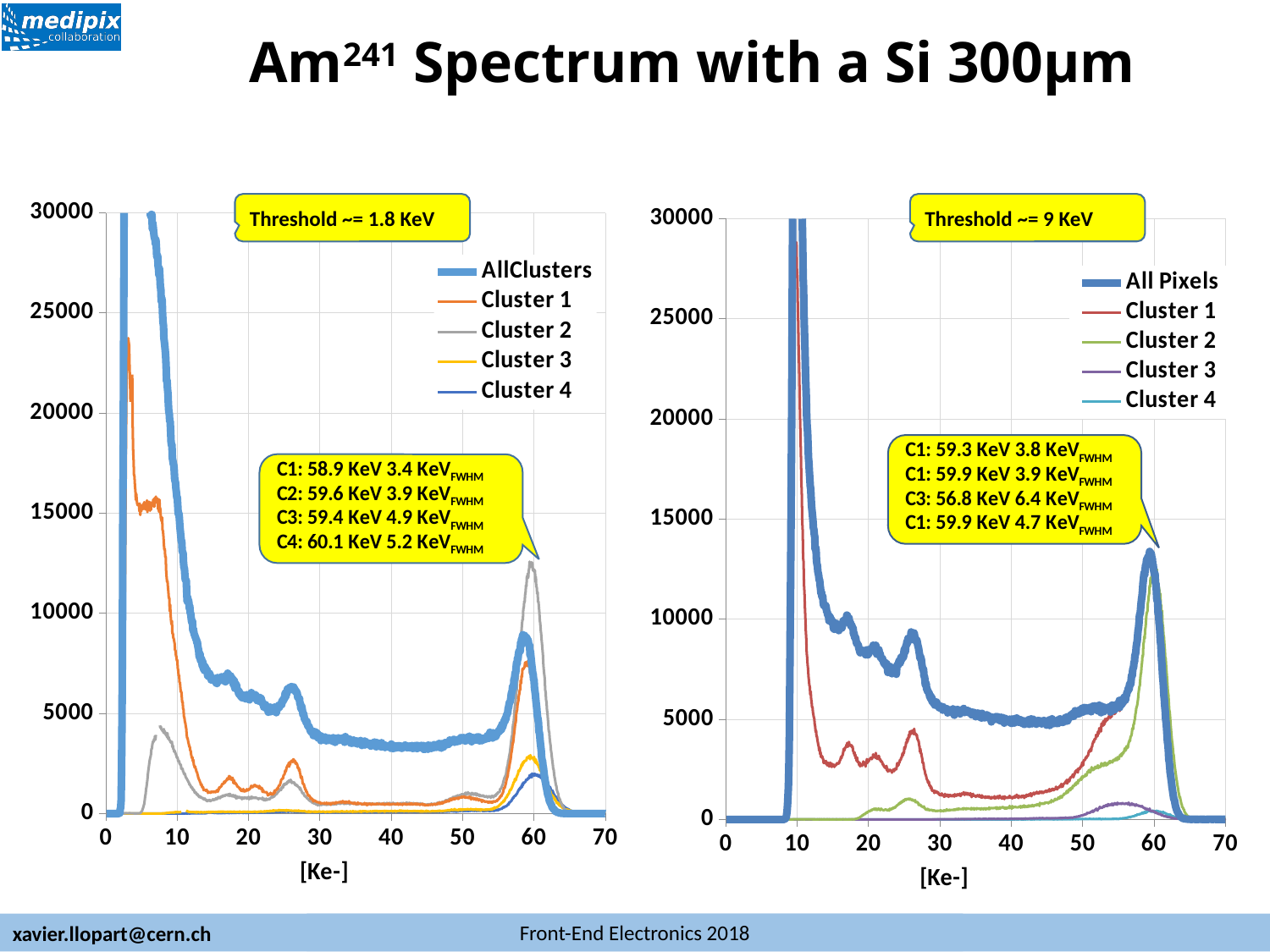
In the left chart, is the peak of Cluster 1 near 3 Ke- greater or less than 20000? greater In the right chart, which series is higher at 60 Ke-, Cluster 2 or Cluster 3? Cluster 2 What kind of chart is shown on the left of the slide? line chart How many series does the legend of the left chart list? 5 In the right chart, which series has the highest value at 30 Ke-? All Pixels In the left chart, is the peak of Cluster 2 near 60 Ke- greater or less than 10000? greater In the right chart, is the peak of All Pixels near 60 Ke- greater or less than 10000? greater What threshold is stated in the yellow callout on the right chart? Threshold ~= 9 KeV In the left chart, which series reaches the highest value near 60 Ke-? Cluster 2 How many series does the legend of the right chart list? 5 What threshold is stated in the yellow callout on the left chart? Threshold ~= 1.8 KeV